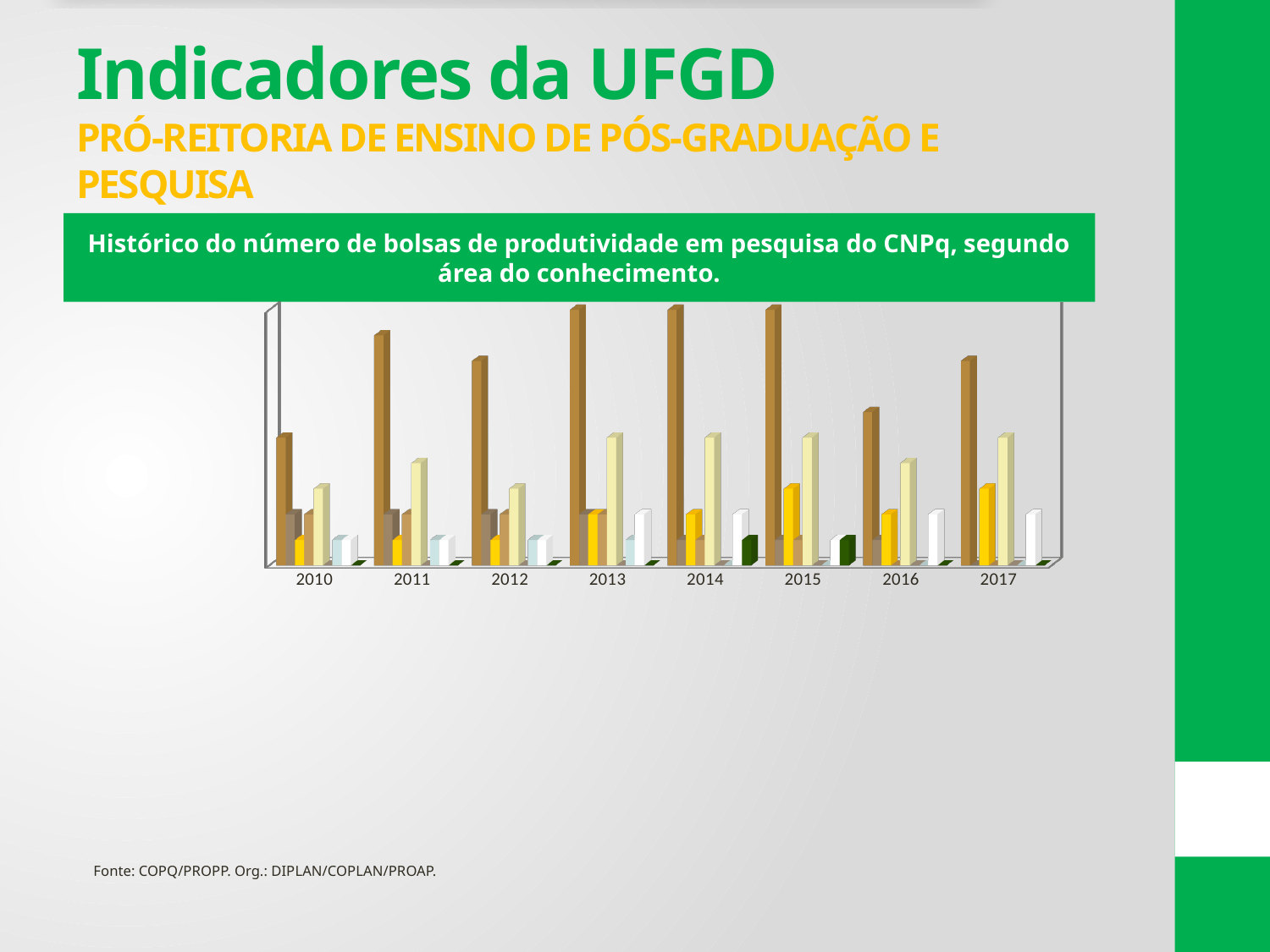
How many years are shown along the x axis of the chart? 8 What is the first year shown on the x axis of the chart? 2010 In which year is the tallest bar of the group the lowest? 2010 What source is cited below the chart? COPQ/PROPP. Org.: DIPLAN/COPLAN/PROAP. Does the tallest bar in each year rise or fall from 2010 to 2013? Rise What is the title of the chart? Histórico do número de bolsas de produtividade em pesquisa do CNPq, segundo área do conhecimento. Does the tallest bar in each year rise or fall from 2015 to 2016? Fall What is the last year shown on the x axis of the chart? 2017 What kind of chart is shown on the slide? Bar chart Is the tallest bar in 2011 taller or shorter than the tallest bar in 2012? Taller